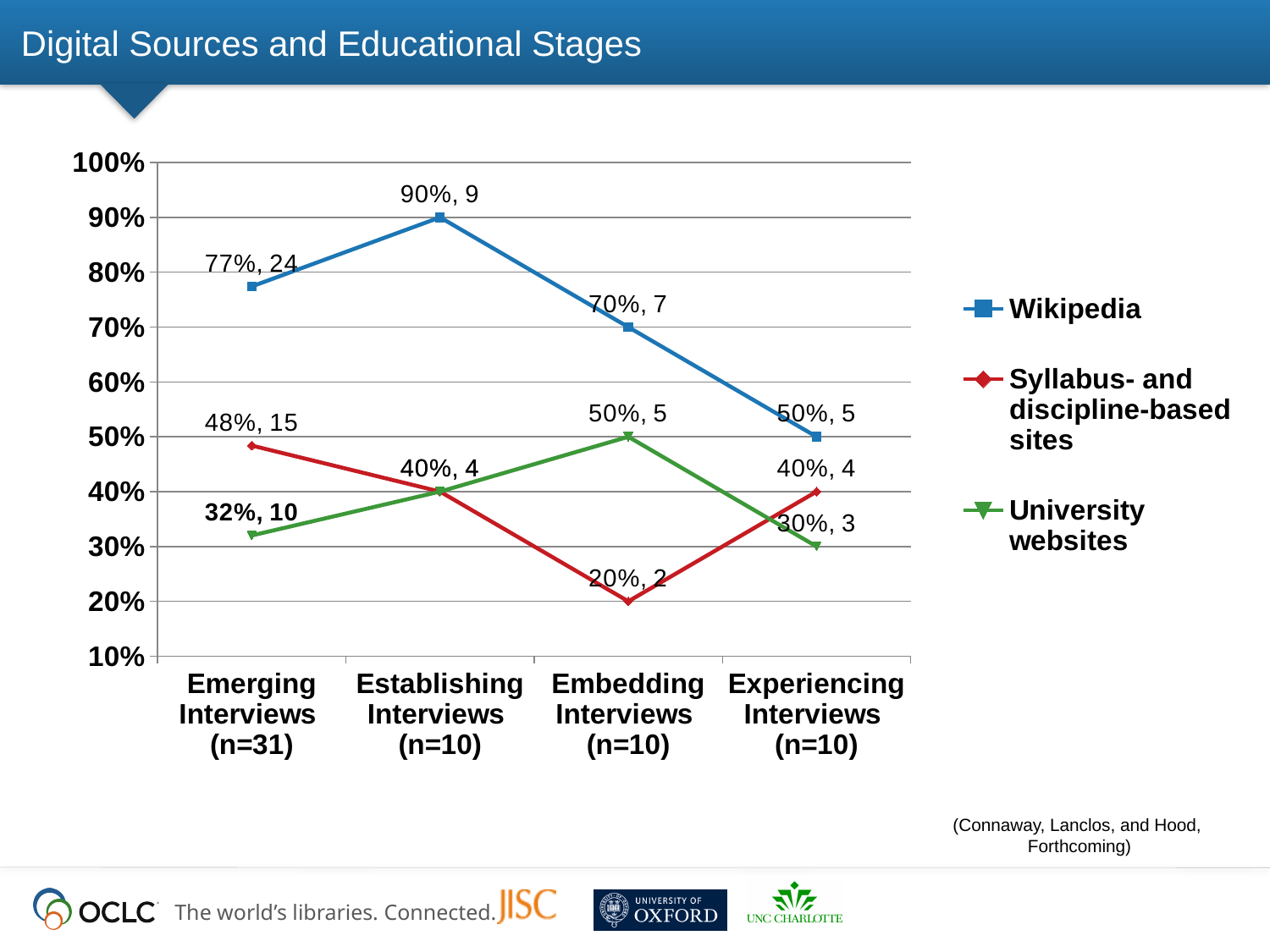
What is the value for University websites at Experiencing Interviews (n=10)? 30%, 3 At Embedding Interviews (n=10), which is larger: the Wikipedia percentage or the University websites percentage? Wikipedia How many series does the legend list? 3 What type of chart is shown on the slide? line chart At which educational stage is the Wikipedia percentage highest? Establishing Interviews (n=10) At which educational stage is the Syllabus- and discipline-based sites percentage lowest? Embedding Interviews (n=10) What is the difference in percentage between Wikipedia and University websites at Emerging Interviews (n=31)? 45% How many educational stage categories are shown on the x axis? 4 What is the Wikipedia value for Establishing Interviews (n=10)? 90%, 9 What is the value for Syllabus- and discipline-based sites at Embedding Interviews (n=10)? 20%, 2 Does the Wikipedia percentage rise or fall from Establishing Interviews to Experiencing Interviews? fall What is the Wikipedia value for Emerging Interviews (n=31)? 77%, 24